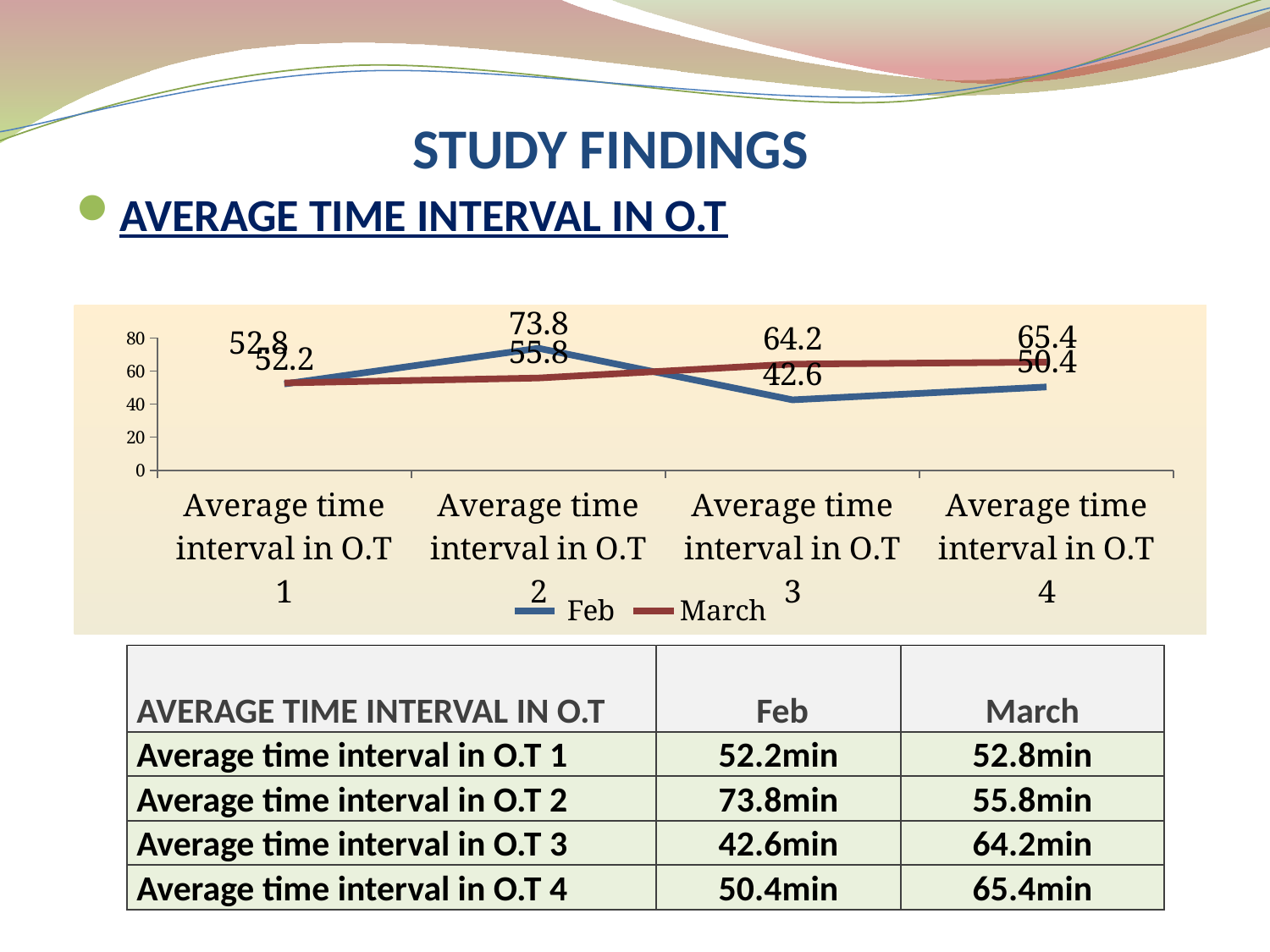
Which category has the lowest Feb value? Average time interval in O.T 3 What is the March value for Average time interval in O.T 3? 64.2 What kind of chart is shown on the slide? line chart Which category has the highest Feb value? Average time interval in O.T 2 Does the March series rise or fall from Average time interval in O.T 1 to Average time interval in O.T 4? rise What is the Feb value for Average time interval in O.T 2? 73.8 Which category has the highest March value? Average time interval in O.T 4 For Average time interval in O.T 2, which series has the larger value, Feb or March? Feb How many categories are plotted along the x axis of the chart? 4 What is the difference between the Feb and March values for Average time interval in O.T 3? 21.6 What is the Feb value for Average time interval in O.T 4? 50.4 How many series does the chart legend list? 2